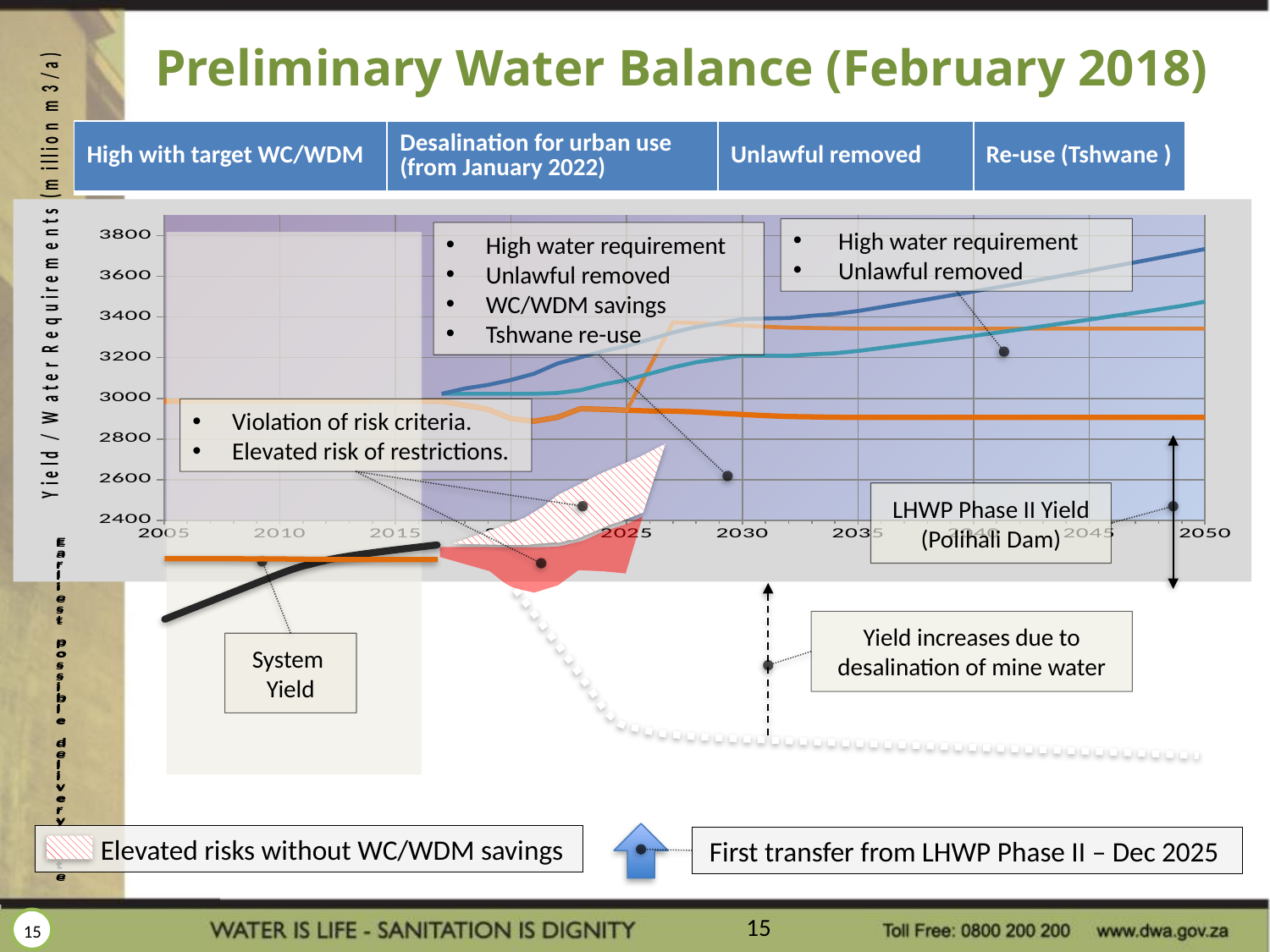
Is the value of the dark blue line at 2020 greater or less than 3200? less What is the label on the vertical axis of the chart? Yield / Water Requirements (million m3/a) Is the value of the teal line at 2030 greater or less than 3400? less How many year tick labels are shown on the x axis? 10 Is the value of the topmost dark blue line at 2050 greater or less than 3600? greater At 2050, which is larger: the dark blue line or the lowest orange line? the dark blue line What kind of chart is shown on the slide? line chart Does the dark blue line rise or fall between 2020 and 2050? rises What is the title of the slide containing the chart? Preliminary Water Balance (February 2018)